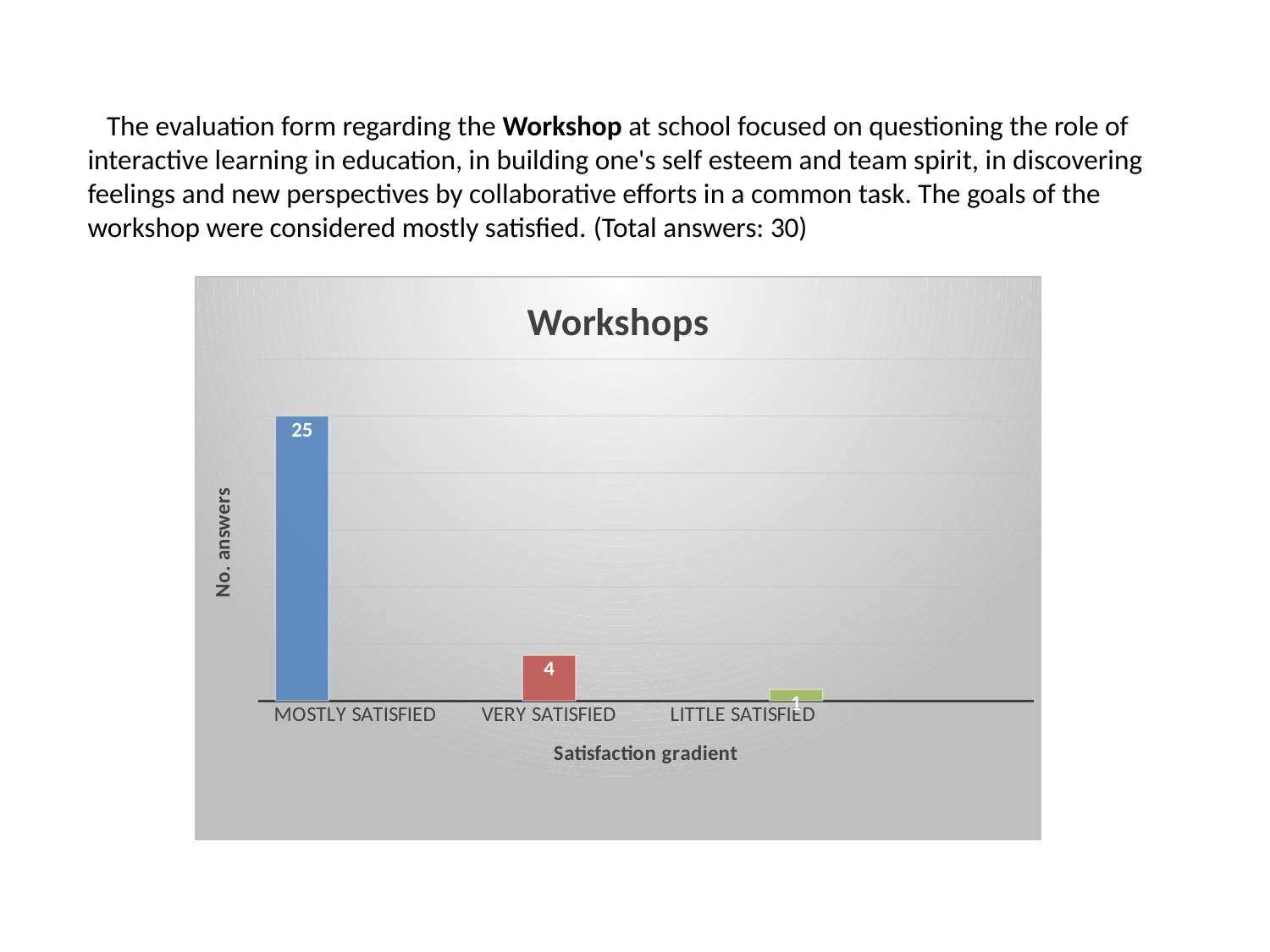
What is the difference between the values for VERY SATISFIED and LITTLE SATISFIED in the Workshops chart? 3 What is the value for MOSTLY SATISFIED in the Workshops chart? 25 What is the label of the vertical axis in the Workshops chart? No. answers What is the difference between the values for MOSTLY SATISFIED and VERY SATISFIED in the Workshops chart? 21 What is the value for LITTLE SATISFIED in the Workshops chart? 1 What kind of chart is the Workshops chart? bar chart Which category has the lowest value in the Workshops chart? LITTLE SATISFIED What is the title of the chart on the slide? Workshops Which category has the highest value in the Workshops chart? MOSTLY SATISFIED Which is larger in the Workshops chart, the value for VERY SATISFIED or the value for LITTLE SATISFIED? VERY SATISFIED How many categories are shown in the Workshops chart? 3 What is the value for VERY SATISFIED in the Workshops chart? 4